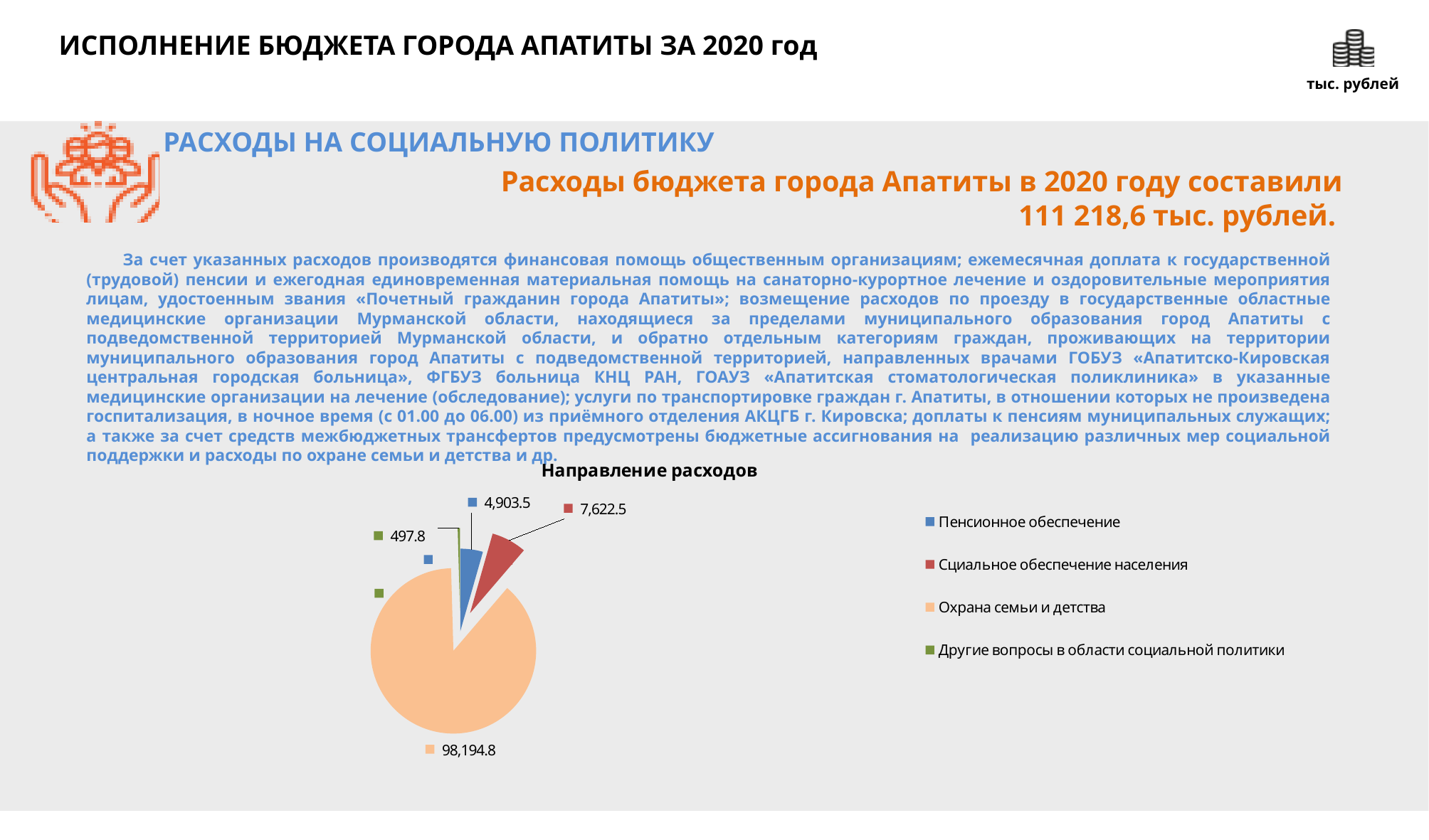
Which category has the largest slice in the pie chart? Охрана семьи и детства What is the value for "Охрана семьи и детства" in the pie chart? 98,194.8 Which is larger in the pie chart: "Пенсионное обеспечение" or "Сциальное обеспечение населения"? Сциальное обеспечение населения What is the value for "Пенсионное обеспечение" in the pie chart? 4,903.5 What is the title of the pie chart? Направление расходов Which category has the smallest slice in the pie chart? Другие вопросы в области социальной политики What is the difference between the values for "Охрана семьи и детства" and "Сциальное обеспечение населения" in the pie chart? 90,572.3 What is the difference between the values for "Сциальное обеспечение населения" and "Пенсионное обеспечение" in the pie chart? 2,719.0 How many categories does the pie chart show? 4 What kind of chart is shown under the title "Направление расходов"? pie chart What is the value for "Сциальное обеспечение населения" in the pie chart? 7,622.5 What is the value for "Другие вопросы в области социальной политики" in the pie chart? 497.8